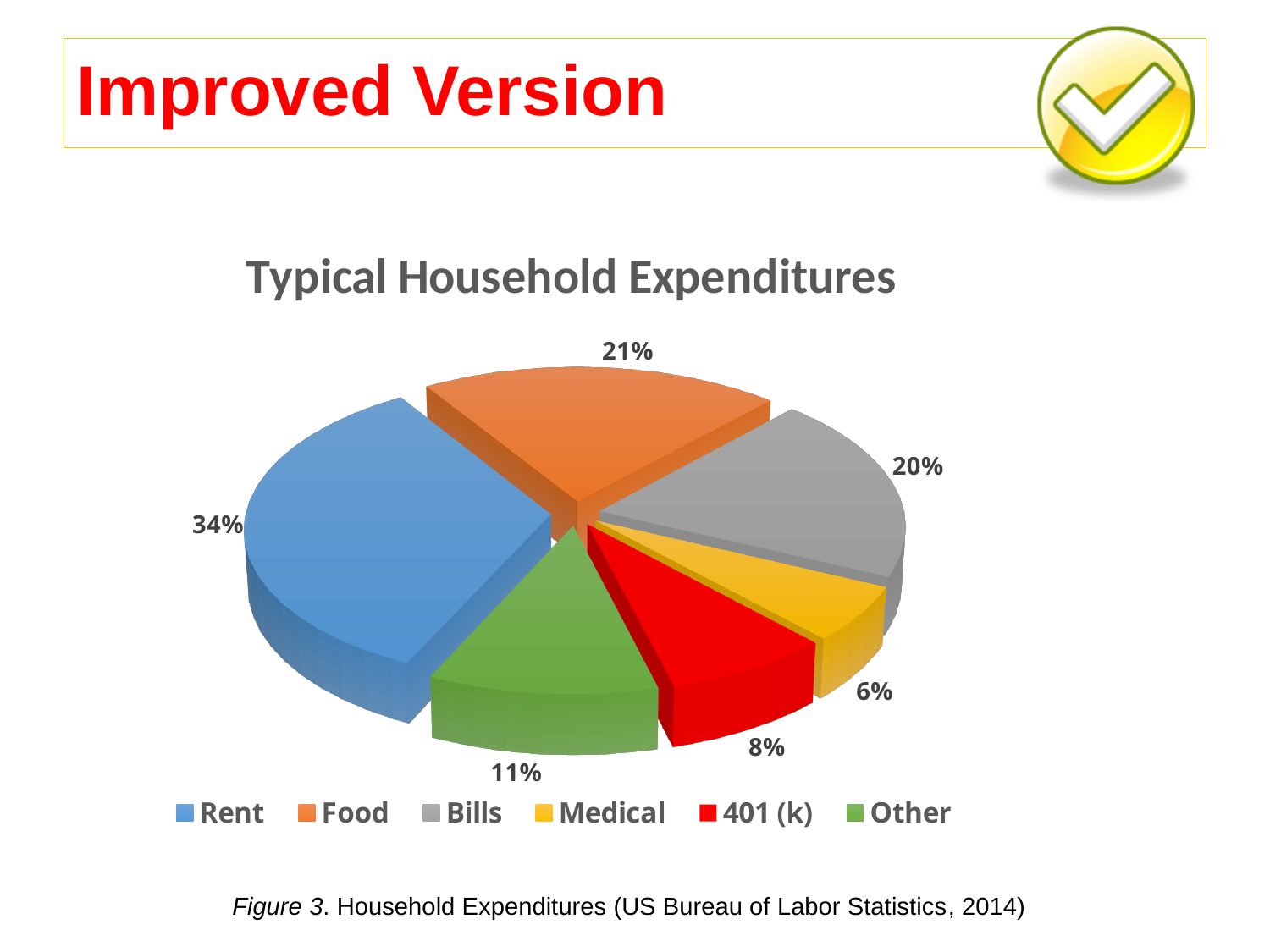
How many categories are shown in the pie chart? 6 What percentage of typical household expenditures goes to Food? 21% What is the difference in percentage points between Rent and Bills? 14 What percentage of typical household expenditures goes to Rent? 34% What percentage of typical household expenditures goes to 401 (k)? 8% What kind of chart is shown on the slide? Pie chart What percentage of typical household expenditures goes to Medical? 6% Which is larger, the share for Other or the share for 401 (k)? Other Which category has the smallest share of typical household expenditures? Medical What colour represents Bills in the pie chart? Gray What is the title of the chart? Typical Household Expenditures Which category has the largest share of typical household expenditures? Rent